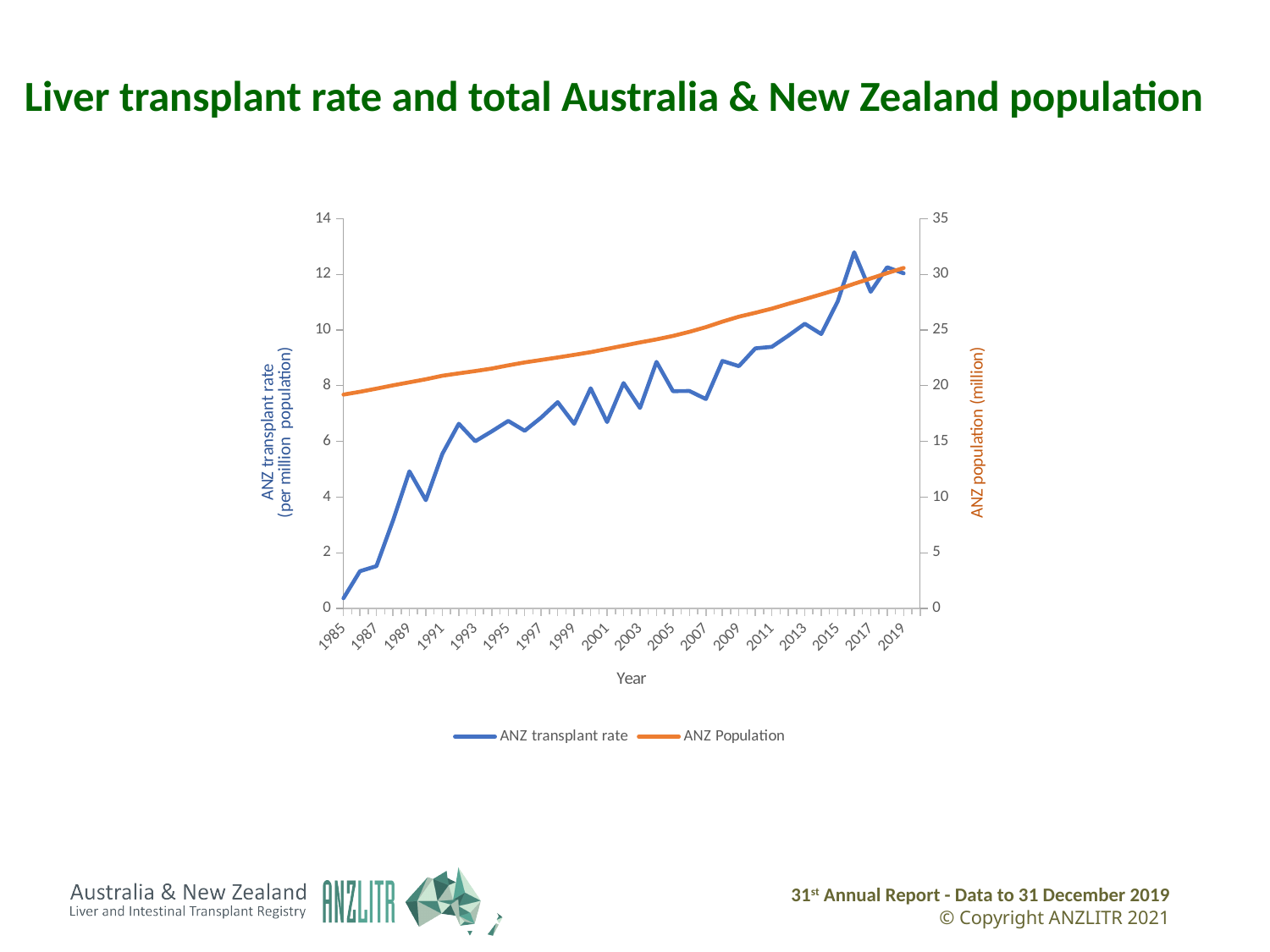
Which is larger, the ANZ transplant rate in 2019 or in 1985? 2019 In which year is the ANZ transplant rate at its lowest? 1985 Is the ANZ population in 1995 greater or less than 25 million? less Does the ANZ Population line rise or fall from 1985 to 2019? rise In which year does the ANZ transplant rate reach its highest value? 2016 Is the ANZ transplant rate in 1985 greater or less than 2? less Is the ANZ transplant rate in 2016 greater or less than 12? greater What is the title of the chart? Liver transplant rate and total Australia & New Zealand population What are the two series named in the legend? ANZ transplant rate and ANZ Population How many series does the legend list? 2 What kind of chart is shown on the slide? line chart